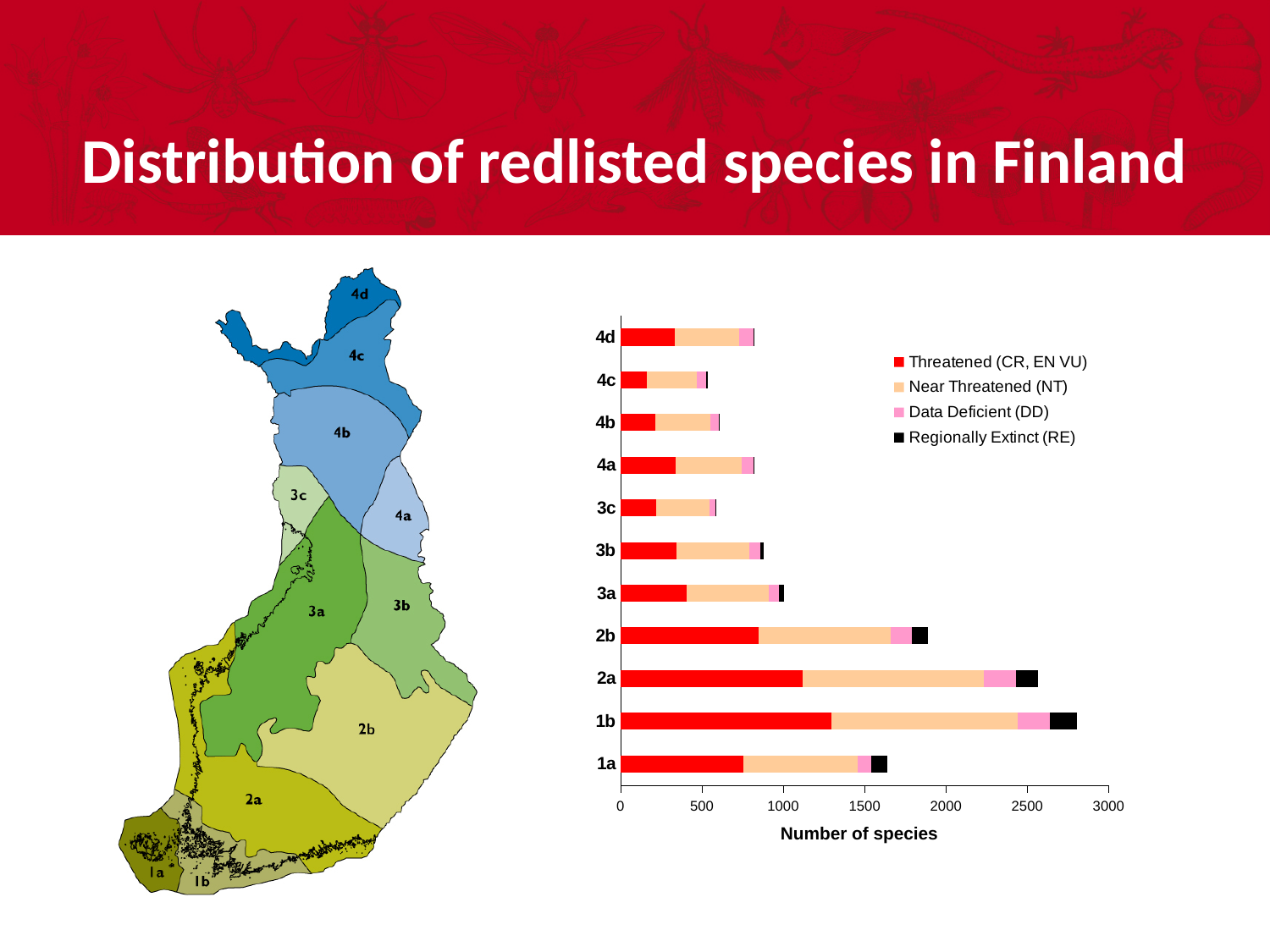
Which region has a longer total bar, 2b or 3a? 2b How many regions (categories) are plotted on the bar chart? 11 Is the total number of species for region 1a greater or less than 1500? greater Is the Threatened (CR, EN VU) value for region 2b greater or less than 1000? less Which region has the longest total bar in the chart? 1b Is the total number of species for region 1b greater or less than 2500? greater Which region has the largest Threatened (CR, EN VU) segment? 1b What is the title of the horizontal axis of the chart? Number of species What kind of chart is shown on the slide? Stacked bar chart How many series does the chart legend list? 4 Which colour represents Regionally Extinct (RE) in the chart legend? Black